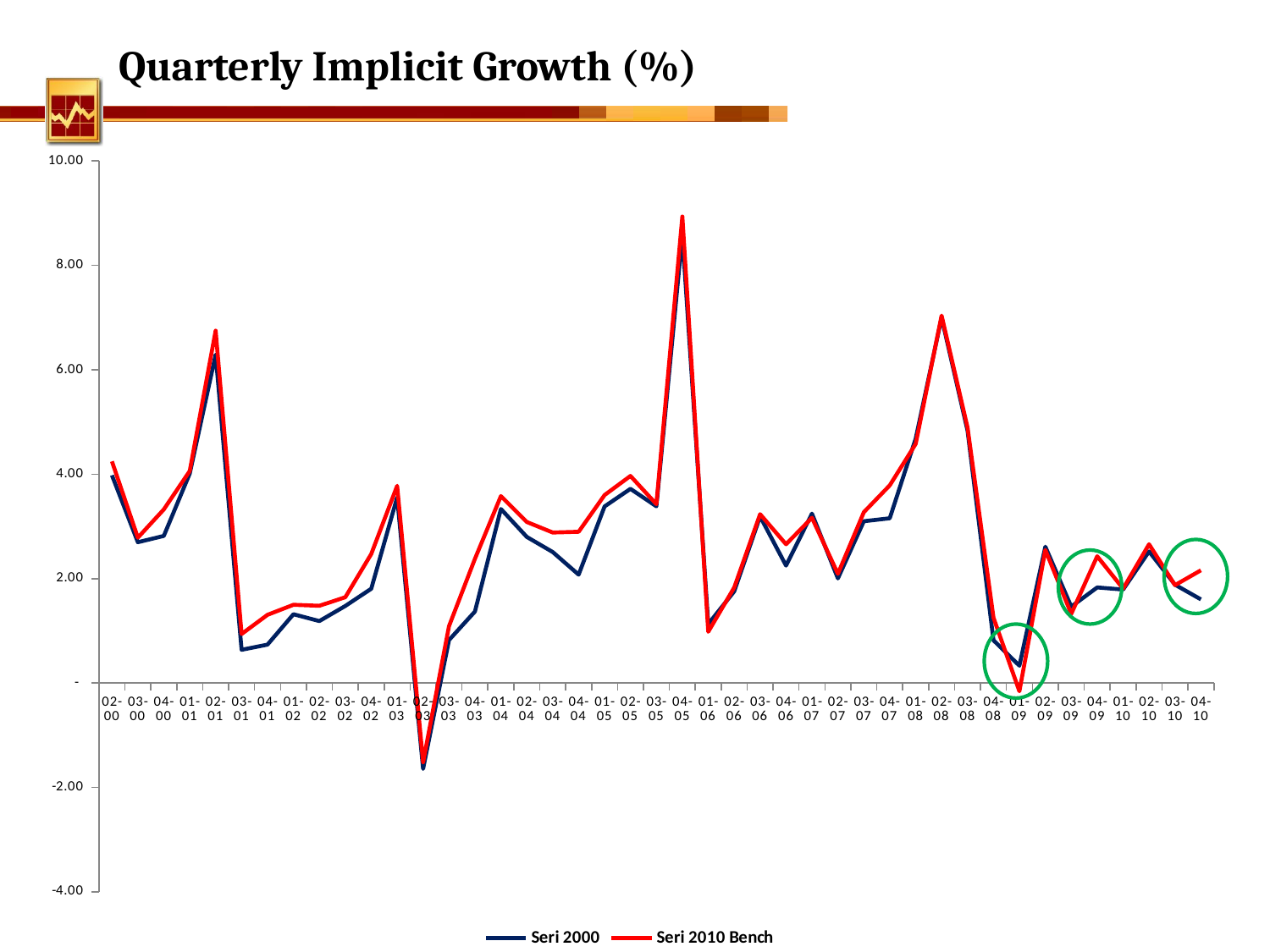
Is the value for Seri 2010 Bench at 01-09 greater or less than 2.00? less How many quarterly points are plotted along the x axis? 43 At which quarter does the Seri 2000 series reach its lowest value? 02-03 What kind of chart is shown on the slide? Line chart At which quarter does the Seri 2010 Bench series reach its highest value? 04-05 Is the value for Seri 2010 Bench at 04-05 greater or less than 8.00? greater Do the values of Seri 2000 rise or fall from 02-08 to 01-09? fall Is the value for Seri 2010 Bench at 02-08 greater or less than 6.00? greater How many series does the legend list? 2 What are the names of the two series in the legend? Seri 2000 and Seri 2010 Bench At 04-10, which series has the higher value, Seri 2000 or Seri 2010 Bench? Seri 2010 Bench